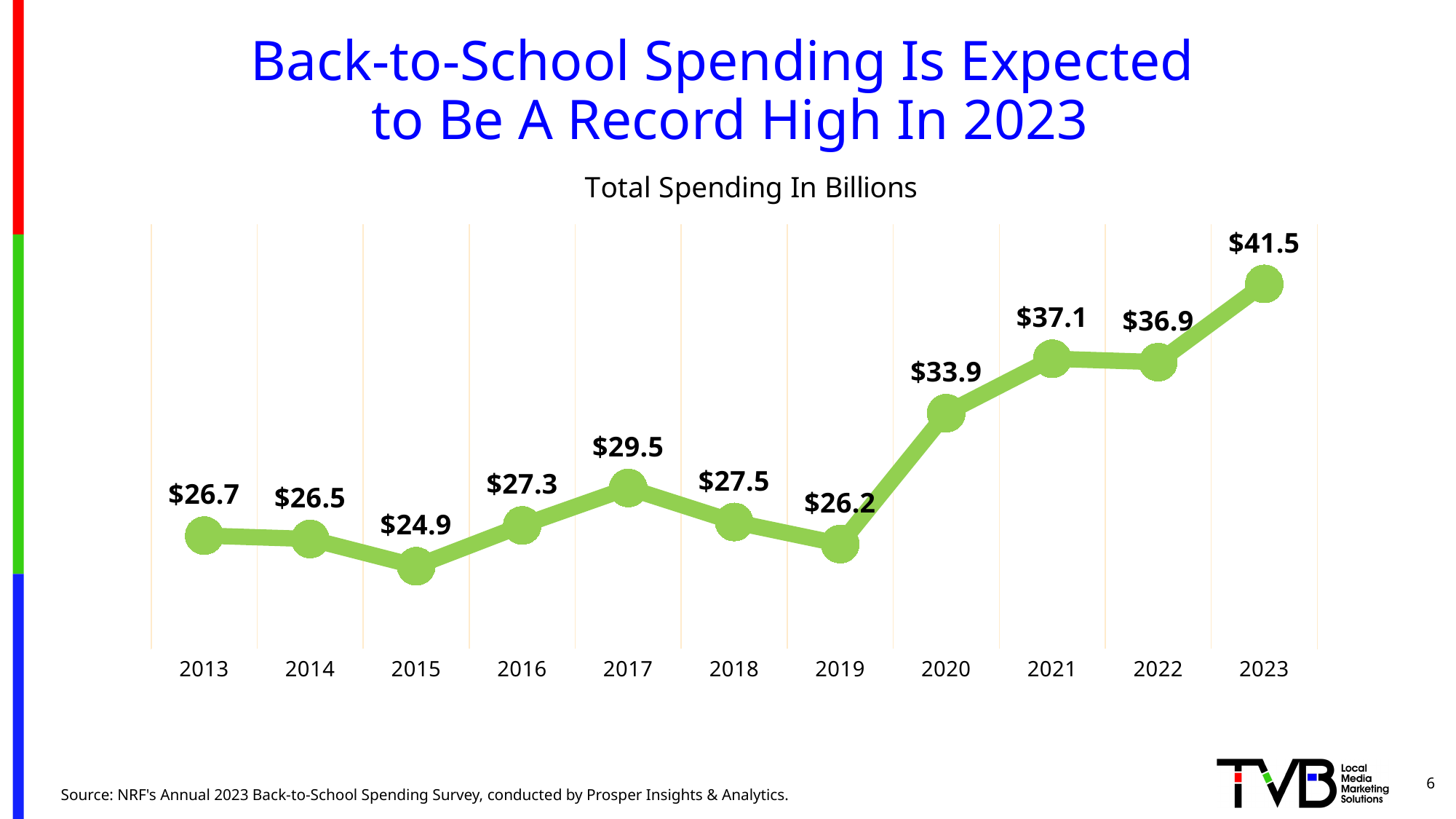
Which year has the highest total spending? 2023 What is the total spending value shown for 2015? $24.9 Which year has higher spending, 2017 or 2018? 2017 Which year has the lowest total spending? 2015 What is the total spending value shown for 2020? $33.9 What kind of chart is shown on the slide? Line chart What is the difference between the 2023 and 2022 spending values? $4.6 What is the subtitle shown above the chart? Total Spending In Billions What is the difference between the 2020 and 2019 spending values? $7.7 What is the total back-to-school spending shown for 2023? $41.5 How many years are plotted on the chart? 11 Does spending rise or fall from 2019 to 2021? Rise